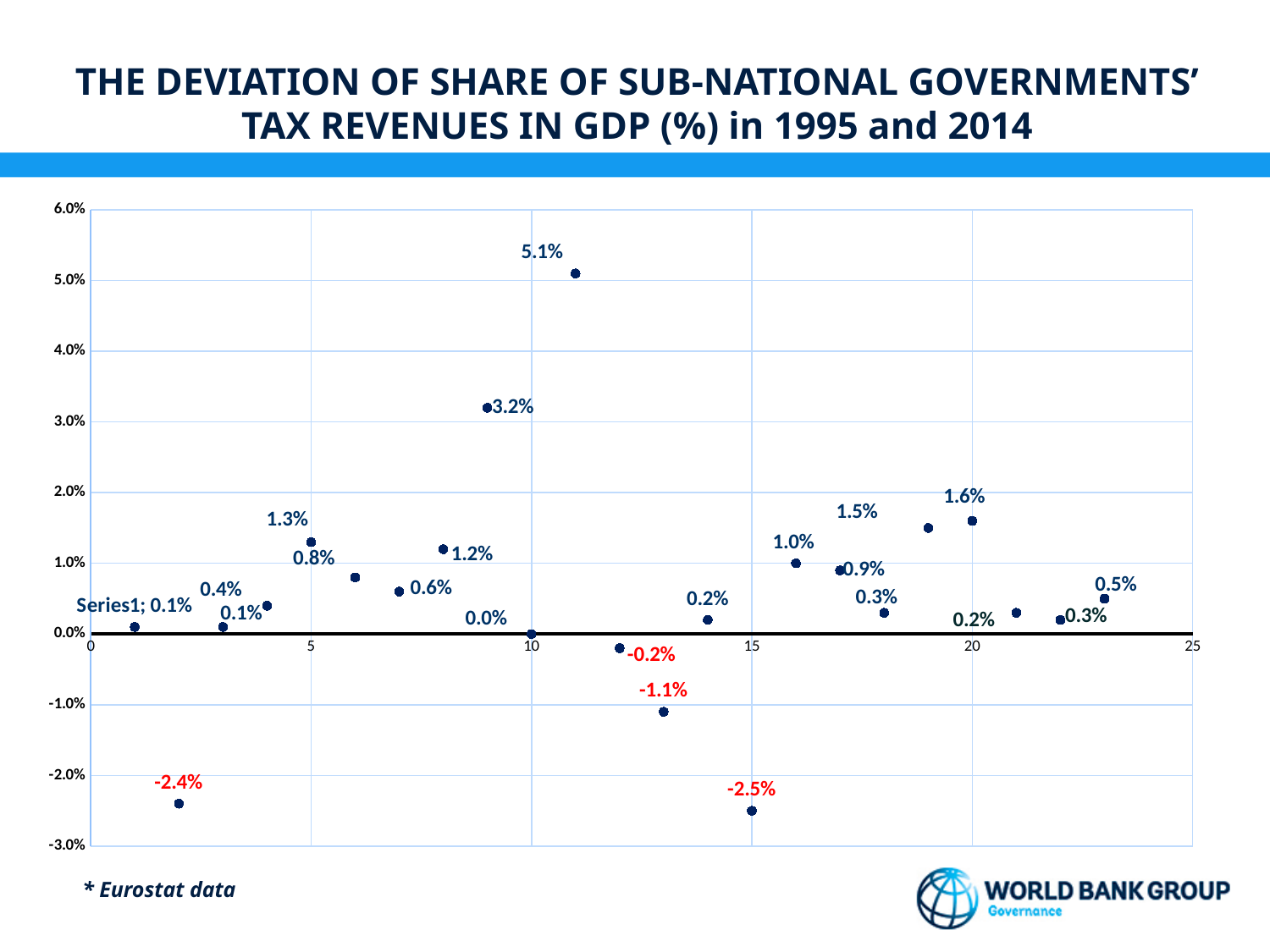
What is the value of the point plotted at x = 10? 0.0% How many of the plotted values are negative? 4 Is the value of the point at x = 11 greater or less than 5.0%? greater What is the difference between the two highest values, 5.1% and 3.2%? 1.9 percentage points What is the value of the point plotted at x = 20? 1.6% How many data points are plotted on the chart? 23 What is the lowest value plotted on the chart? -2.5% Which is larger, the value at x = 20 or the value at x = 5? The value at x = 20 (1.6%) What is the value of the point plotted at x = 5? 1.3% What kind of chart is shown on the slide? Scatter chart What is the value of the point plotted at x = 15? -2.5% What is the highest value plotted on the chart? 5.1%